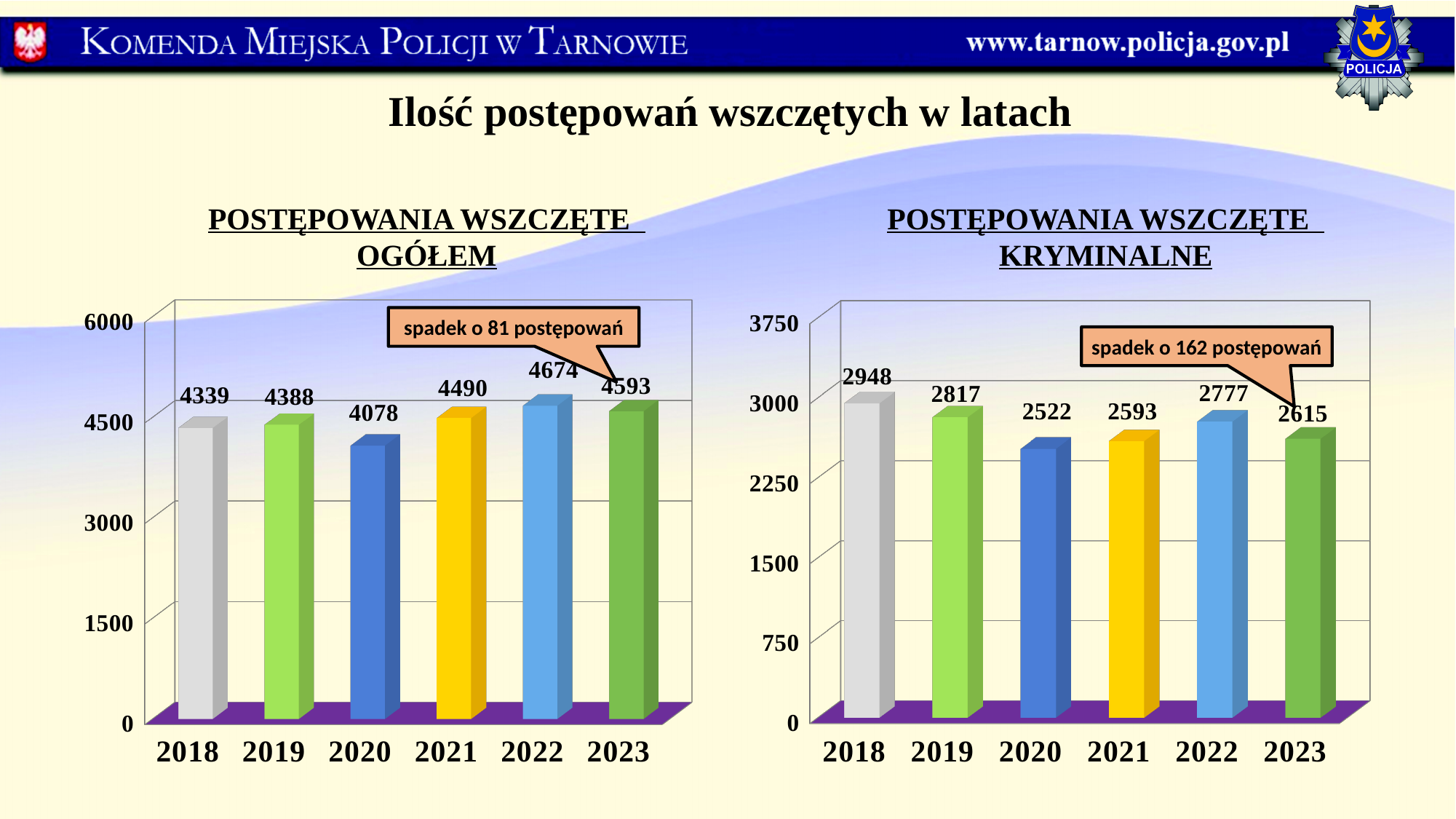
In the chart titled POSTĘPOWANIA WSZCZĘTE KRYMINALNE, what is the value for 2018? 2948 In the chart titled POSTĘPOWANIA WSZCZĘTE OGÓŁEM, what is the difference between the values for 2022 and 2023? 81 In the chart titled POSTĘPOWANIA WSZCZĘTE KRYMINALNE, what is the difference between the values for 2022 and 2023? 162 What is the main title of the slide above the two charts? Ilość postępowań wszczętych w latach In the chart titled POSTĘPOWANIA WSZCZĘTE OGÓŁEM, is the value for 2021 greater or less than 4500? less How many years are shown on the x axis of the chart titled POSTĘPOWANIA WSZCZĘTE KRYMINALNE? 6 In the chart titled POSTĘPOWANIA WSZCZĘTE KRYMINALNE, which is larger, the value for 2019 or the value for 2022? 2019 In the chart titled POSTĘPOWANIA WSZCZĘTE OGÓŁEM, what is the value for 2020? 4078 In the chart titled POSTĘPOWANIA WSZCZĘTE KRYMINALNE, which year has the lowest value? 2020 In the chart titled POSTĘPOWANIA WSZCZĘTE OGÓŁEM, which year has the highest value? 2022 What kind of chart is the chart titled POSTĘPOWANIA WSZCZĘTE OGÓŁEM? bar chart In the chart titled POSTĘPOWANIA WSZCZĘTE OGÓŁEM, did the value rise or fall from 2020 to 2022? rise